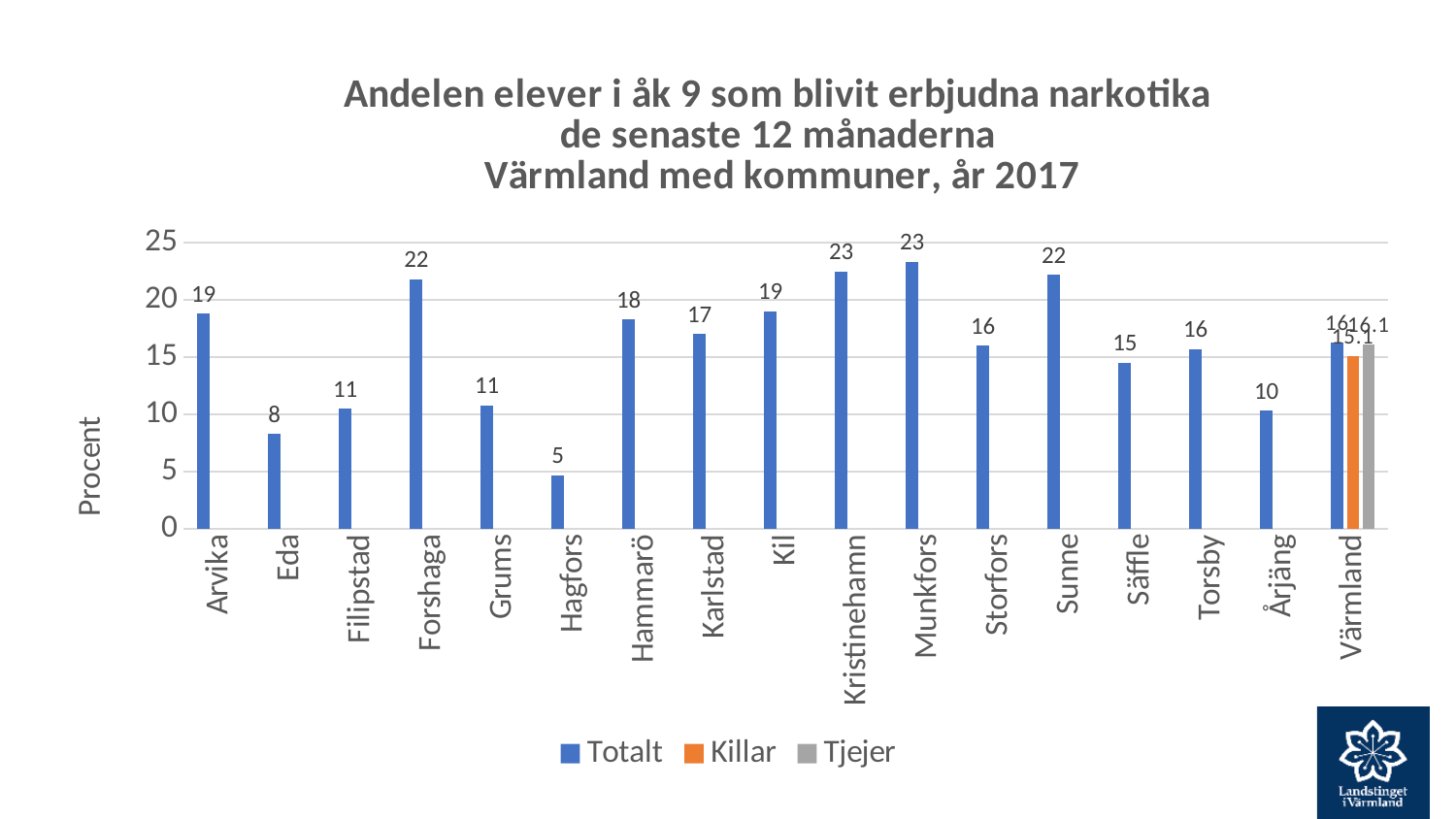
What is the difference between the Totalt values for Kristinehamn and Eda? 15 What is the Totalt value for Forshaga? 22 How many series does the legend list? 3 How many categories are shown on the x axis? 17 Which has a higher Totalt value, Sunne or Säffle? Sunne What kind of chart is shown on the slide? bar chart What is the Tjejer value for Värmland? 16.1 What is the Totalt value for Hagfors? 5 What is the Killar value for Värmland? 15.1 What is the label of the y axis? Procent Which municipality has the lowest Totalt value? Hagfors Is the Totalt value for Hammarö greater or less than 15? greater